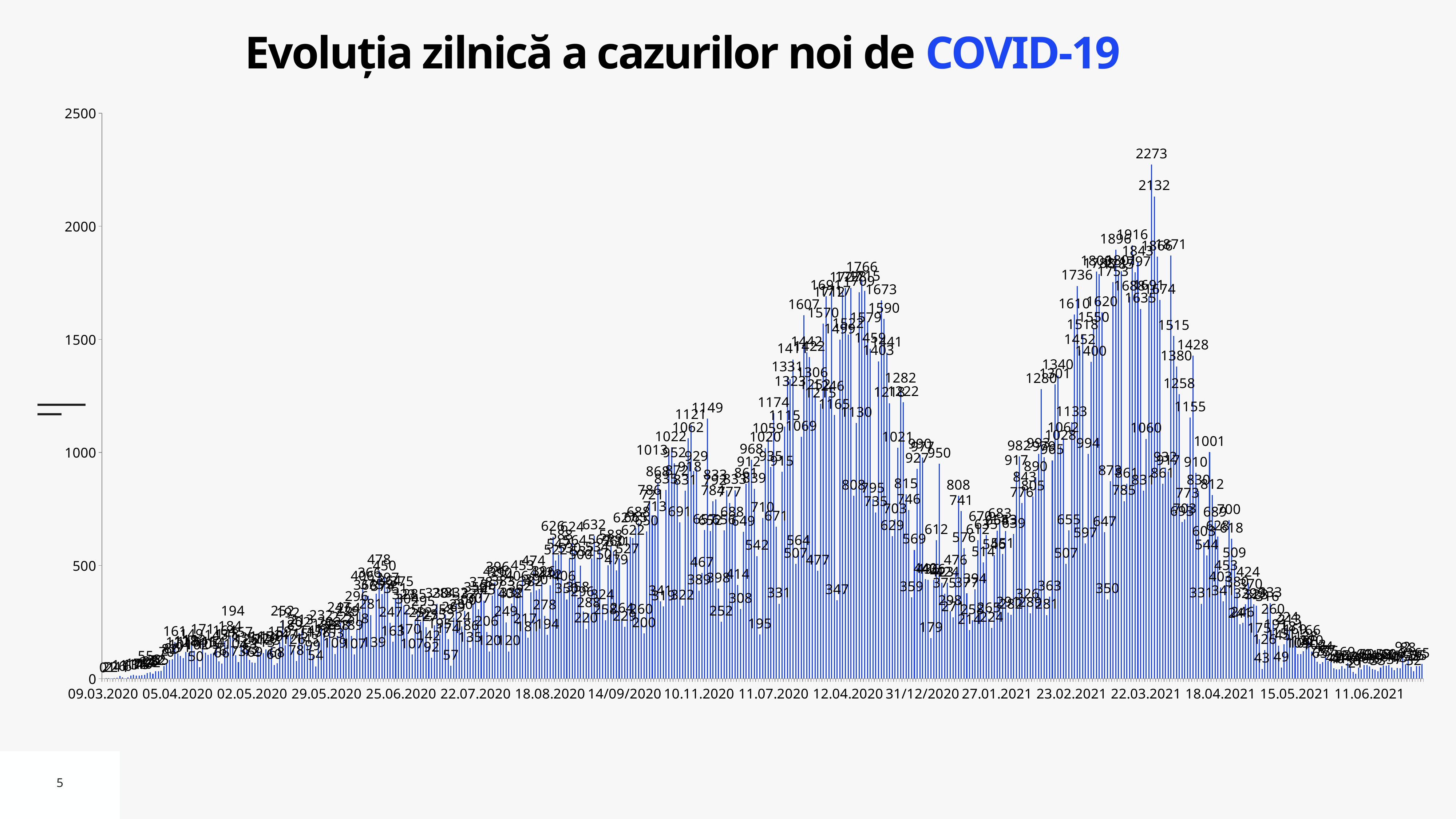
Do the daily values rise or fall over the first weeks after 09.03.2020? rise Is the highest bar on the chart greater or less than 2000? greater What is the second-highest daily value labelled on the chart? 2132 What is the highest daily value labelled on the chart? 2273 What is the maximum value shown on the vertical axis? 2500 What is the last date shown on the horizontal axis? 11.06.2021 What kind of chart is shown on the slide? bar chart Are the bars at the far right of the chart (around 11.06.2021) greater or less than 500? less Which is larger, the peak labelled 2273 or the peak labelled 1766? 2273 What is the difference between the two highest labelled values, 2273 and 2132? 141 What is the first date shown on the horizontal axis? 09.03.2020 What is the title of the chart? Evoluția zilnică a cazurilor noi de COVID-19